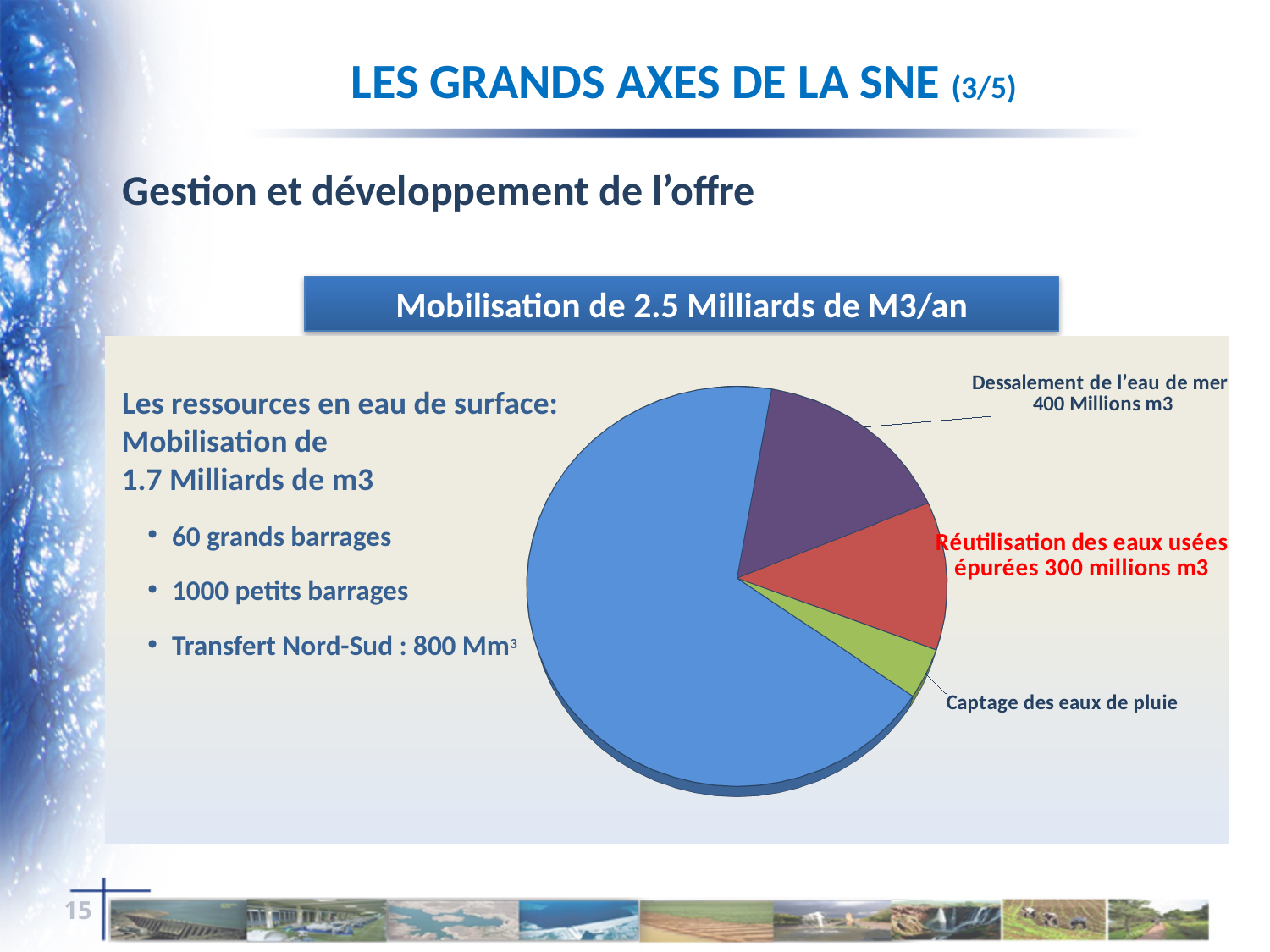
Which slice of the pie chart is larger: 'Captage des eaux de pluie' or 'Dessalement de l'eau de mer'? Dessalement de l'eau de mer What colour is the 'Réutilisation des eaux usées épurées' slice in the pie chart? red What value is given for 'Dessalement de l'eau de mer' in the pie chart? 400 Millions m3 How many slices does the pie chart have? 4 Which labelled slice of the pie chart is the smallest? Captage des eaux de pluie What is the difference between the values for 'Dessalement de l'eau de mer' and 'Réutilisation des eaux usées épurées'? 100 millions m3 What colour is the 'Dessalement de l'eau de mer' slice in the pie chart? purple What kind of chart is shown on the slide? pie chart Which is larger in the pie chart: 'Dessalement de l'eau de mer' or 'Réutilisation des eaux usées épurées'? Dessalement de l'eau de mer What value is given for 'Réutilisation des eaux usées épurées' in the pie chart? 300 millions m3